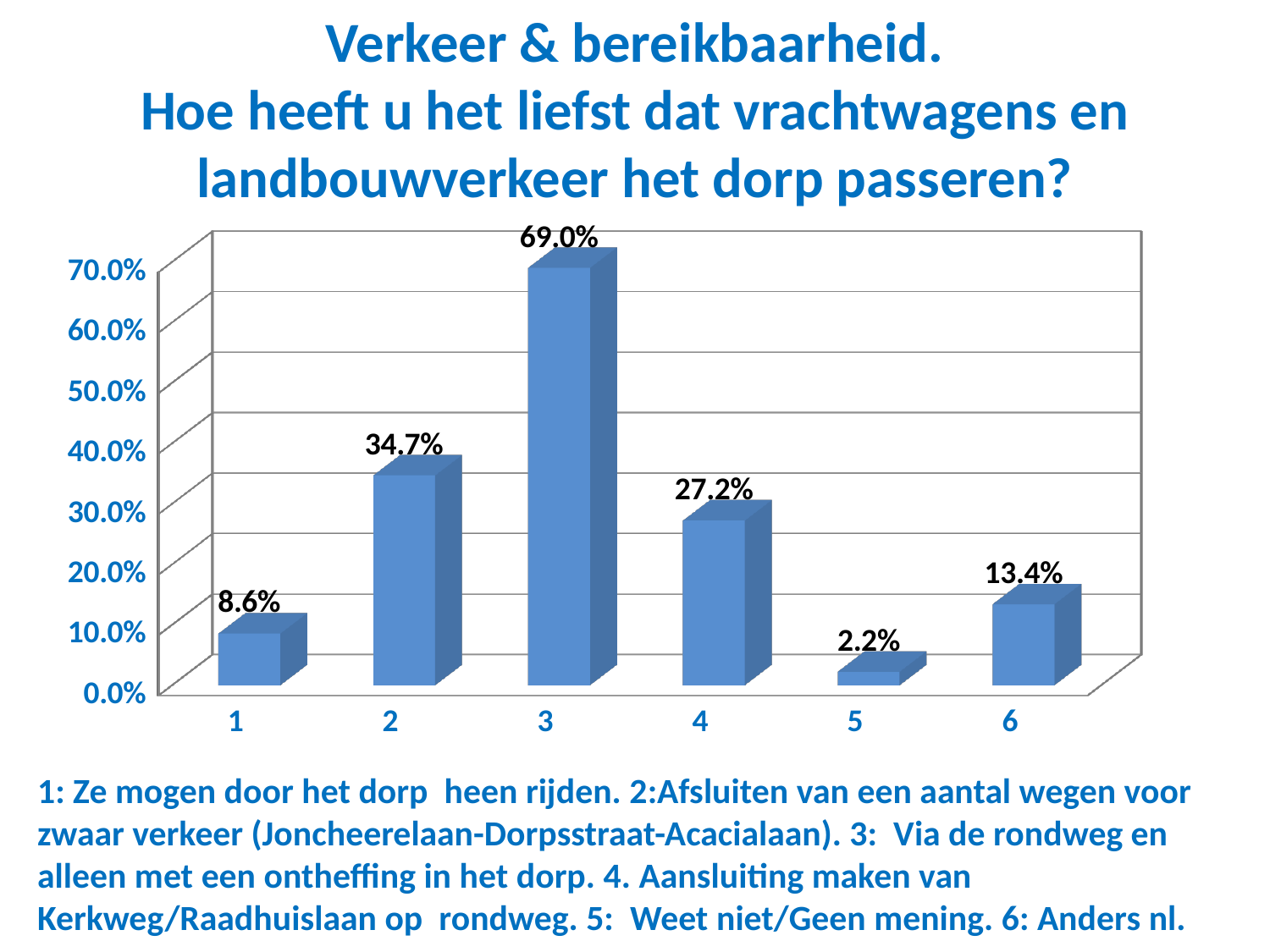
What is the highest value labelled on the y axis? 70.0% What is the difference between the values for category 3 and category 2? 34.3% What kind of chart is shown on the slide? bar chart What is the value for category 3? 69.0% What is the value for category 1? 8.6% Is the value for category 2 greater or less than 30.0%? greater Which is larger, the value for category 4 or the value for category 6? 4 What is the difference between the values for category 2 and category 4? 7.5% Which category has the lowest value? 5 What is the value for category 6? 13.4% Which category has the highest value? 3 How many categories are shown on the x axis? 6